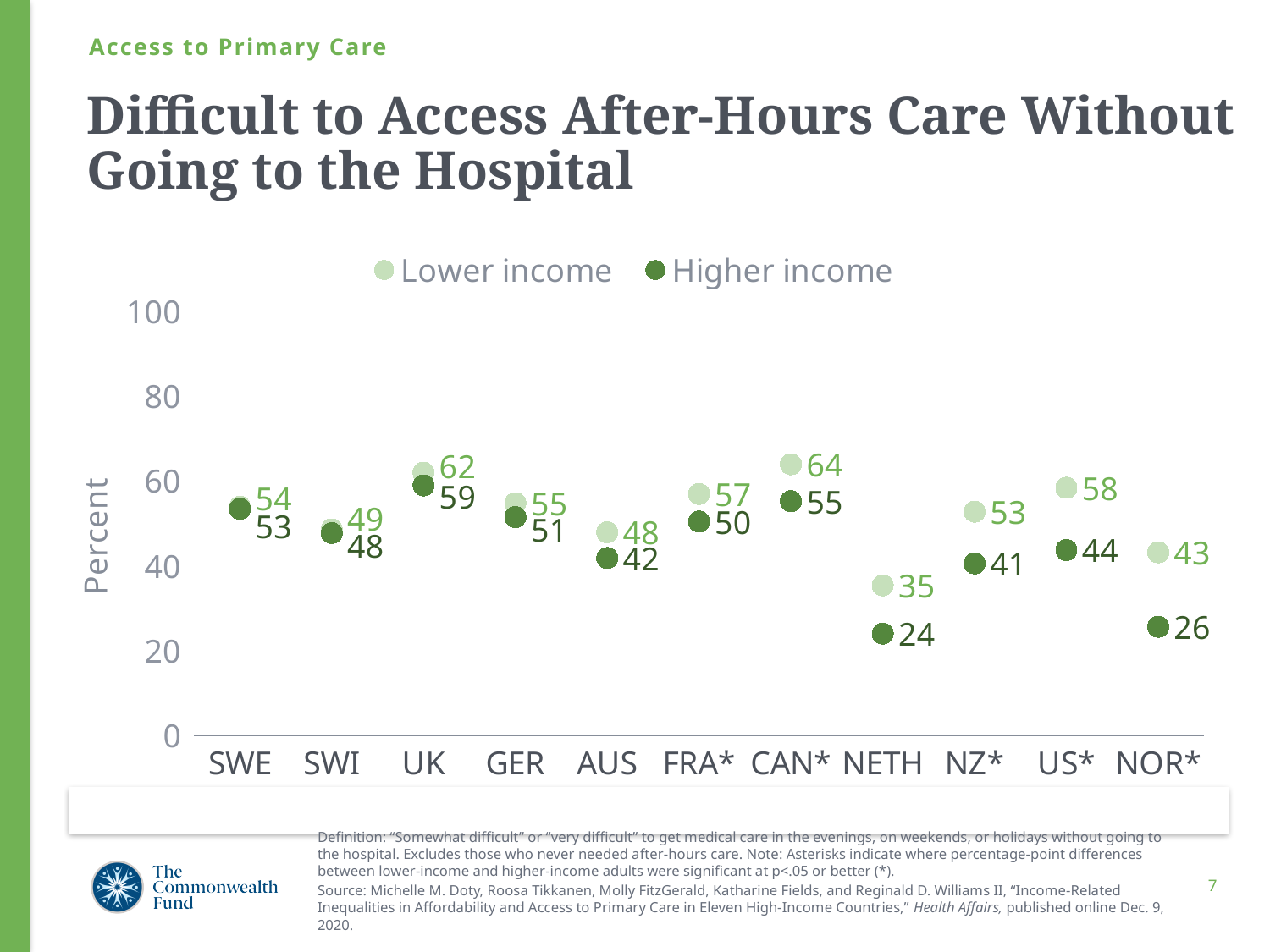
What is the Lower income value for CAN*? 64 What is the label of the y axis? Percent What is the difference between the Lower income and Higher income values for NOR*? 17 What is the Higher income value for NETH? 24 Which country has the lowest Higher income value? NETH What kind of chart is shown on the slide? Dot (scatter) chart What is the difference between the Lower income and Higher income values for US*? 14 Which is larger, the Lower income value for AUS or the Higher income value for GER? Higher income value for GER Which country has the highest Lower income value? CAN* How many series does the legend list? 2 How many countries are shown on the x axis? 11 What is the Higher income value for UK? 59